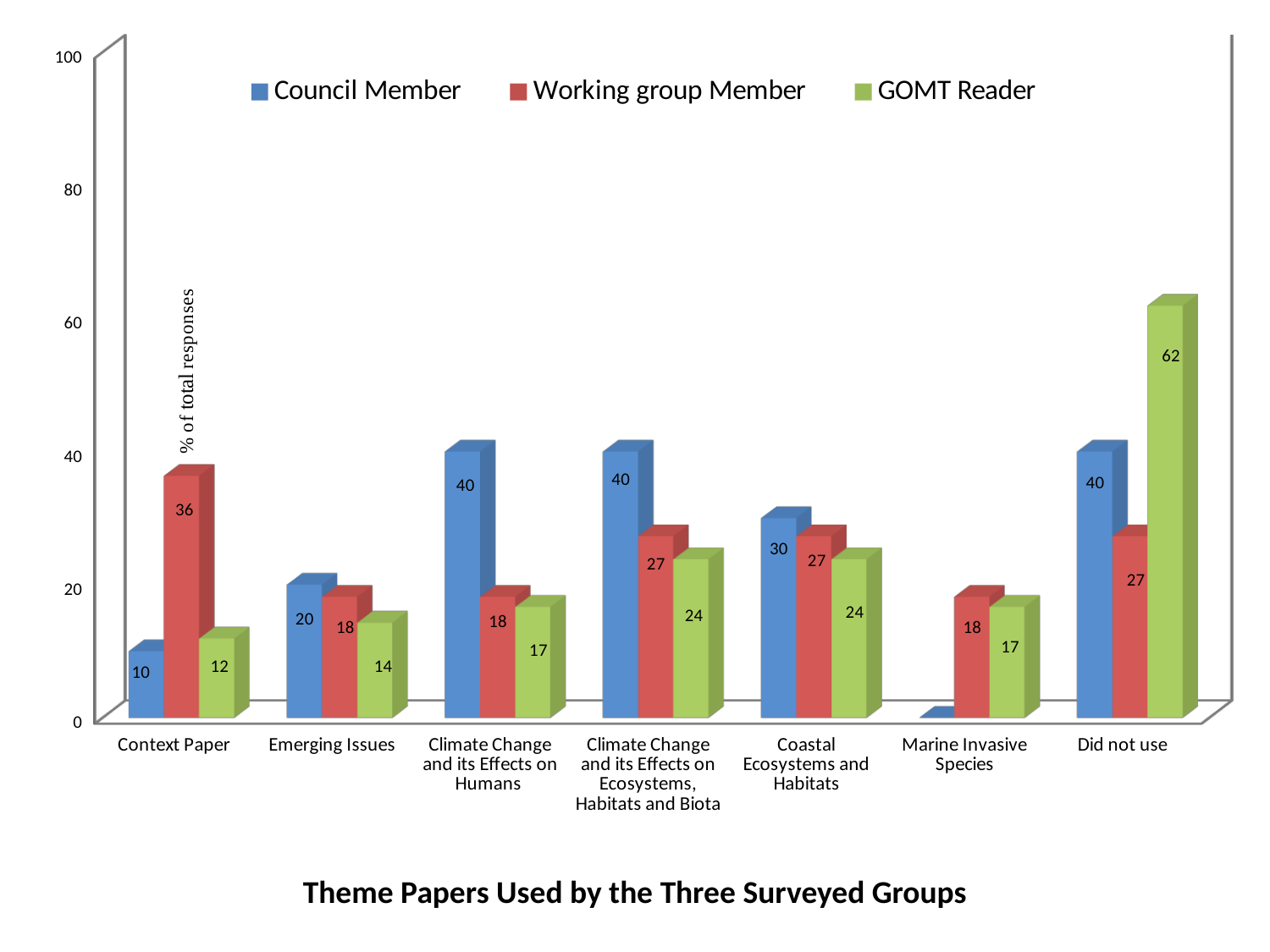
What is the value for Working group Member for Context Paper? 36 What is the difference between the GOMT Reader and Council Member values for Did not use? 22 How many categories are shown on the x axis? 7 Which is larger for Context Paper: the Council Member value or the GOMT Reader value? GOMT Reader How many series does the legend list? 3 What is the value for Council Member for Coastal Ecosystems and Habitats? 30 What is the title of the chart? Theme Papers Used by the Three Surveyed Groups Is the Working group Member value for Context Paper greater or less than 40? less What kind of chart is shown on the slide? bar chart Which category has the highest GOMT Reader value? Did not use What is the value for GOMT Reader for Did not use? 62